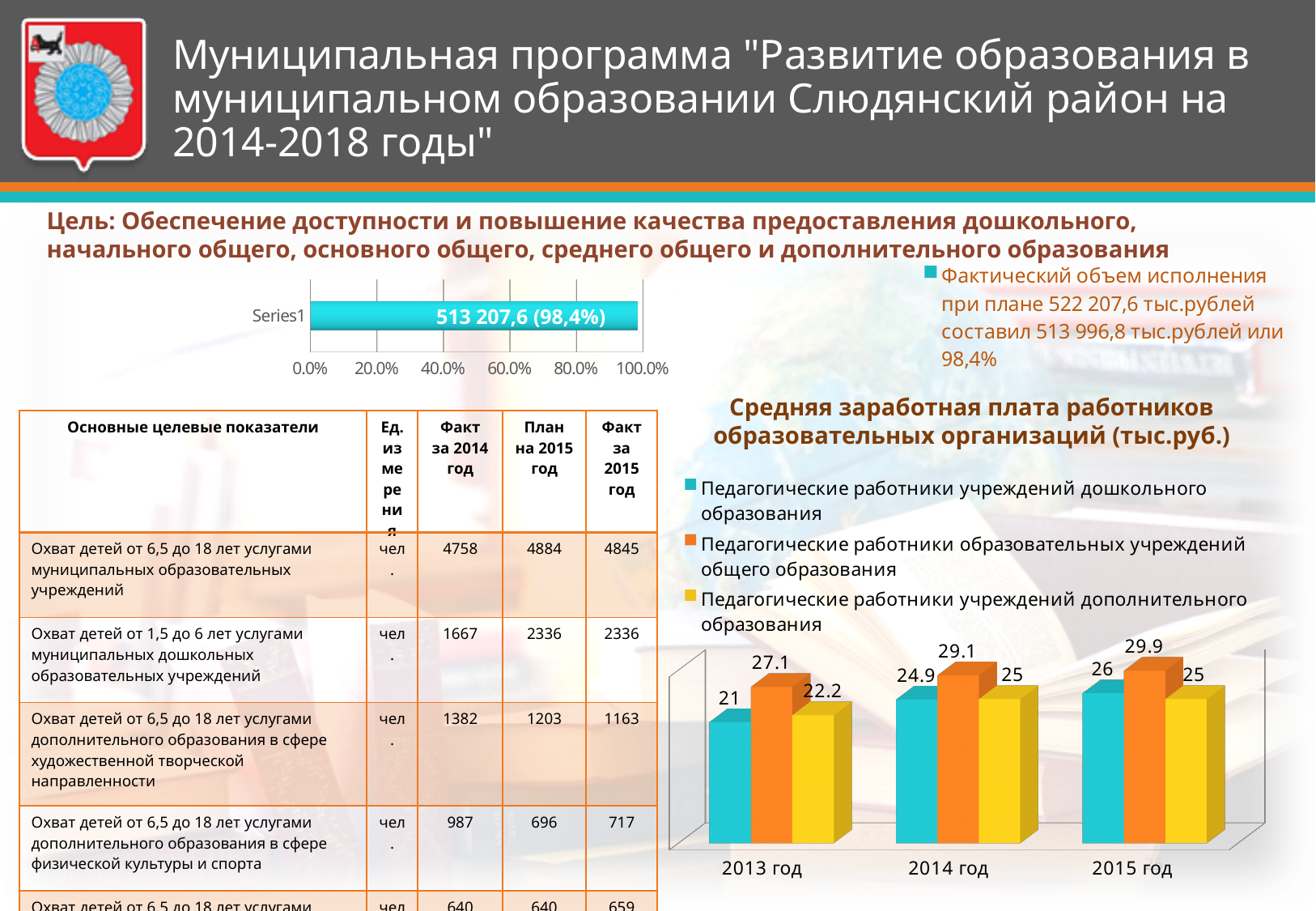
In the chart 'Средняя заработная плата работников образовательных организаций (тыс.руб.)', which is larger in 2013 год: 'Педагогические работники учреждений дошкольного образования' or 'Педагогические работники учреждений дополнительного образования'? Педагогические работники учреждений дополнительного образования What kind of chart is the small chart at the top of the slide labelled 'Series1'? Bar chart In the chart 'Средняя заработная плата работников образовательных организаций (тыс.руб.)', what is the value for 'Педагогические работники образовательных учреждений общего образования' in 2015 год? 29.9 In the chart 'Средняя заработная плата работников образовательных организаций (тыс.руб.)', what is the value for 'Педагогические работники учреждений дошкольного образования' in 2013 год? 21 In the chart 'Средняя заработная плата работников образовательных организаций (тыс.руб.)', which year has the lowest value for 'Педагогические работники образовательных учреждений общего образования'? 2013 год In the chart 'Средняя заработная плата работников образовательных организаций (тыс.руб.)', how does the value for 'Педагогические работники образовательных учреждений общего образования' change from 2013 год to 2015 год? It rises How many series does the legend of the chart 'Средняя заработная плата работников образовательных организаций (тыс.руб.)' list? 3 In the chart 'Средняя заработная плата работников образовательных организаций (тыс.руб.)', what is the value for 'Педагогические работники учреждений дополнительного образования' in 2014 год? 25 In the chart 'Средняя заработная плата работников образовательных организаций (тыс.руб.)', which year has the highest value for 'Педагогические работники учреждений дошкольного образования'? 2015 год What data label is shown on the bar in the small 'Series1' chart at the top of the slide? 513 207,6 (98,4%) In the chart 'Средняя заработная плата работников образовательных организаций (тыс.руб.)', what is the difference between the 2015 год and 2013 год values for 'Педагогические работники учреждений дошкольного образования'? 5 How many year categories are shown in the chart 'Средняя заработная плата работников образовательных организаций (тыс.руб.)'? 3